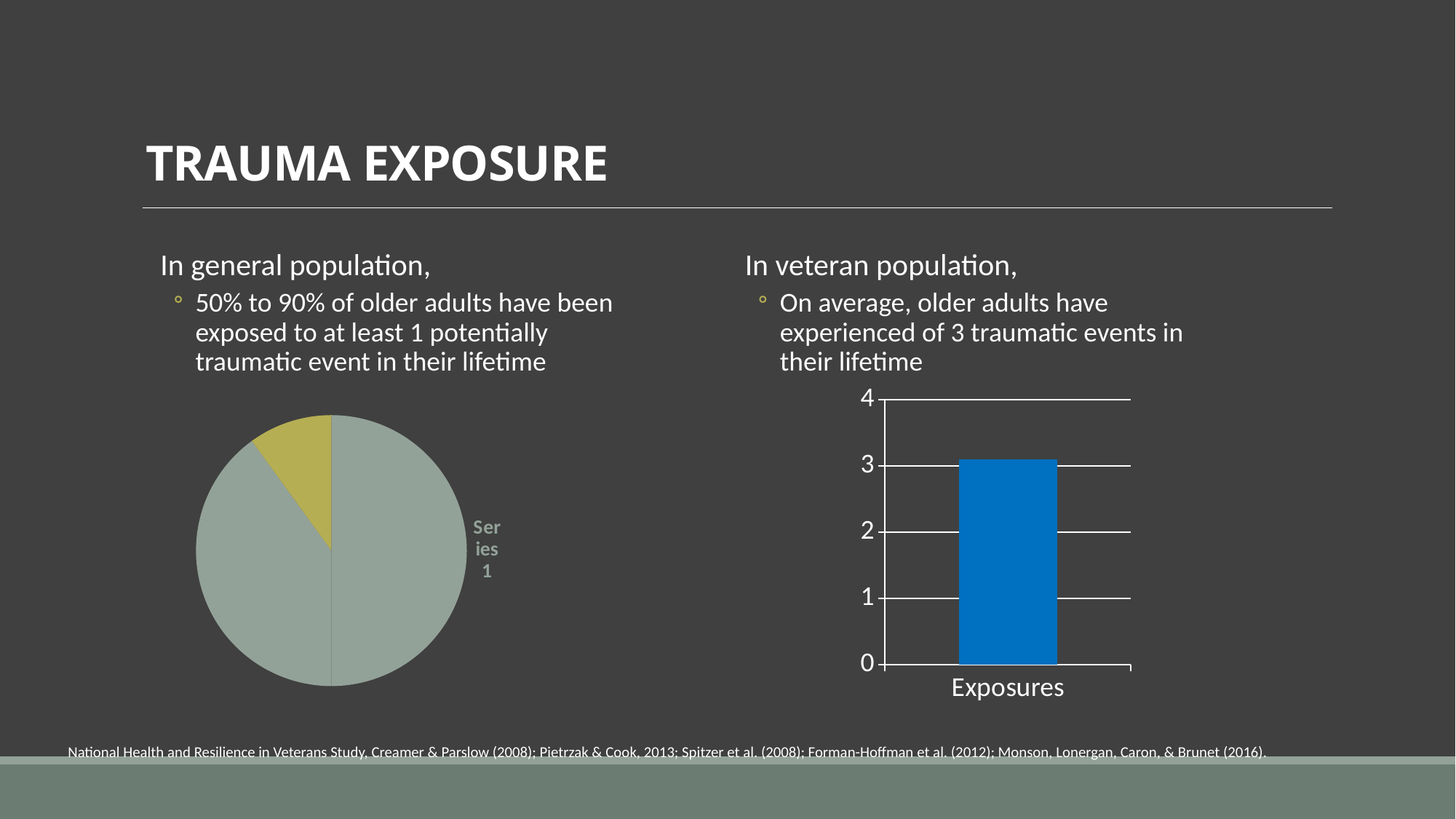
In the bar chart on the right, is the value for Exposures greater or less than 2? greater In the bar chart on the right, how many bars are plotted? 1 In the bar chart on the right, what is the label of the category on the x axis? Exposures What kind of chart is shown on the right side of the slide, under 'In veteran population'? bar chart What kind of chart is shown on the left side of the slide, under 'In general population'? pie chart In the bar chart on the right, is the value for Exposures greater or less than 4? less In the pie chart on the left, how many slices does the pie have? 3 In the bar chart on the right, is the value for Exposures greater or less than 1? greater In the bar chart on the right, what is the highest value shown on the vertical axis? 4 In the pie chart on the left, which slice is larger: the slice labelled 'Series 1' or the unlabelled yellow slice? Series 1